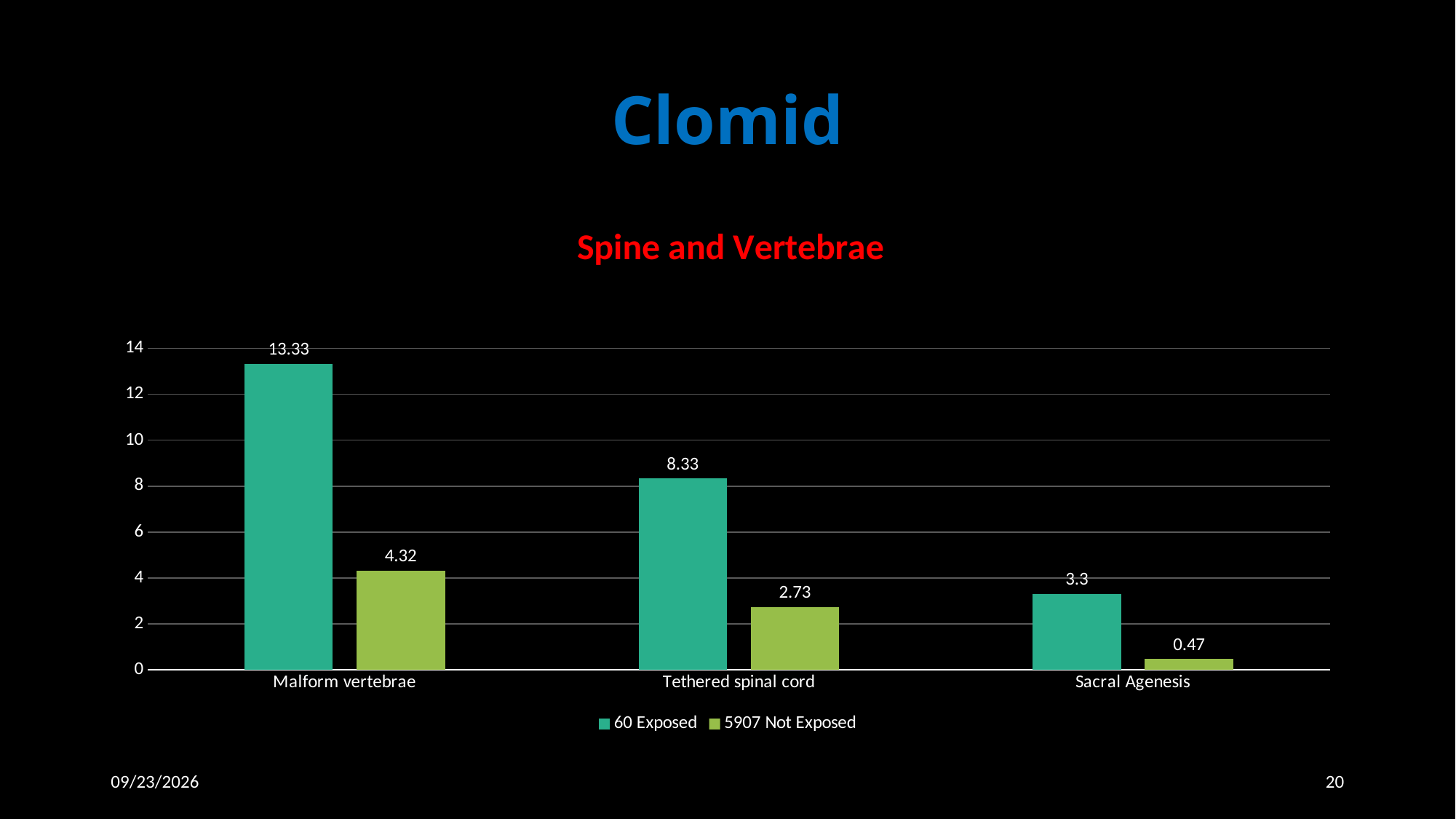
What is the difference between the 60 Exposed and 5907 Not Exposed values for Malform vertebrae? 9.01 How many categories are shown on the x axis? 3 What is the value for Tethered spinal cord in the 5907 Not Exposed series? 2.73 How many series does the legend list? 2 What is the title of the chart? Spine and Vertebrae Which is larger for Tethered spinal cord: the 60 Exposed value or the 5907 Not Exposed value? 60 Exposed What is the value for Malform vertebrae in the 60 Exposed series? 13.33 Which category has the lowest value in the 5907 Not Exposed series? Sacral Agenesis What is the value for Sacral Agenesis in the 60 Exposed series? 3.3 Is the 60 Exposed value for Tethered spinal cord greater or less than 8? greater What kind of chart is shown on the slide? Bar chart Which category has the highest value in the 60 Exposed series? Malform vertebrae